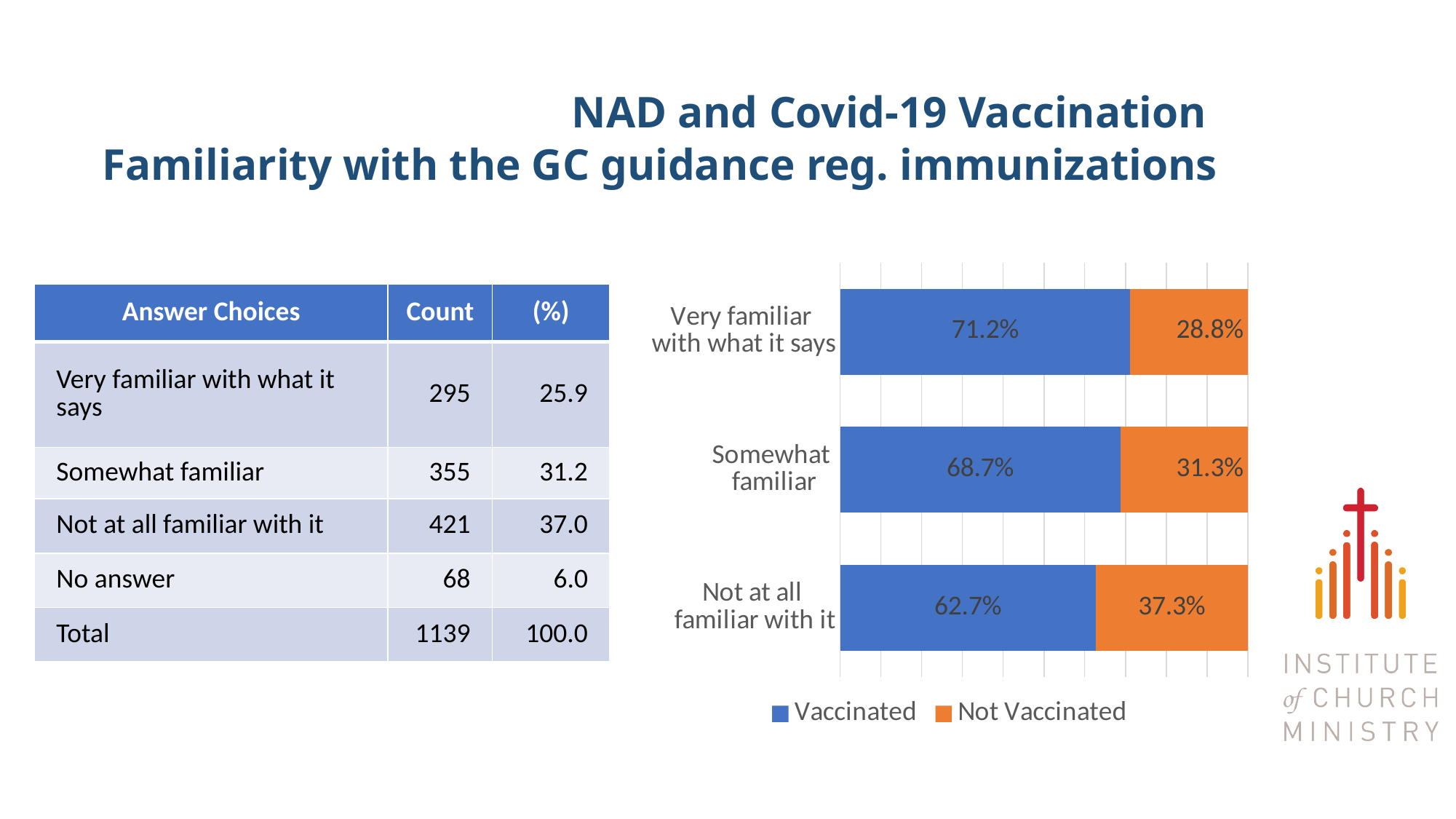
How many series does the legend list? 2 Which category has the highest Not Vaccinated share? Not at all familiar with it Which category has the highest Vaccinated share? Very familiar with what it says Is the Vaccinated value for 'Somewhat familiar' larger or smaller than the Vaccinated value for 'Very familiar with what it says'? smaller What is the Not Vaccinated value for 'Very familiar with what it says'? 28.8% How many categories are shown in the chart? 3 Which category has the lowest Vaccinated share? Not at all familiar with it What kind of chart is shown on the slide? stacked bar chart What is the Not Vaccinated value for 'Somewhat familiar'? 31.3% What is the difference between the Vaccinated and Not Vaccinated values for 'Not at all familiar with it'? 25.4% What is the Vaccinated value for 'Very familiar with what it says'? 71.2% What is the Vaccinated value for 'Not at all familiar with it'? 62.7%